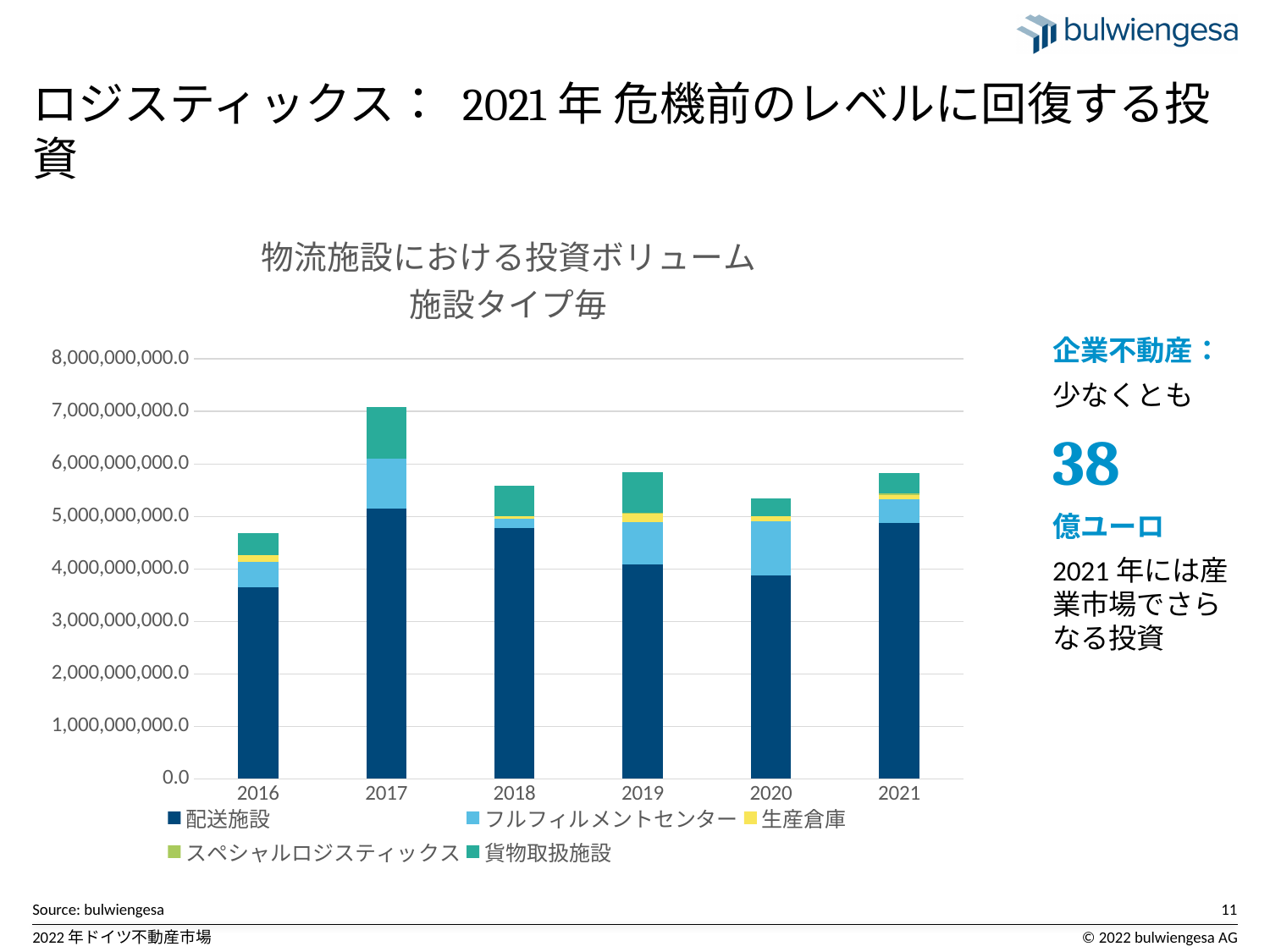
Is the total investment volume for 2020 greater or less than 5,000,000,000.0? greater Which year has the highest total investment volume in the chart? 2017 How many years are shown on the x axis of the chart? 6 Does the total investment volume rise or fall from 2016 to 2017? rise Is the 配送施設 value for 2017 greater or less than 5,000,000,000.0? greater How many series does the chart's legend list? 5 Is the 配送施設 value for 2018 greater or less than 4,000,000,000.0? greater Which year has the larger total investment volume, 2017 or 2021? 2017 Which year has the lowest total investment volume in the chart? 2016 What kind of chart is shown on the slide? stacked bar chart What is the title of the chart? 物流施設における投資ボリューム 施設タイプ毎